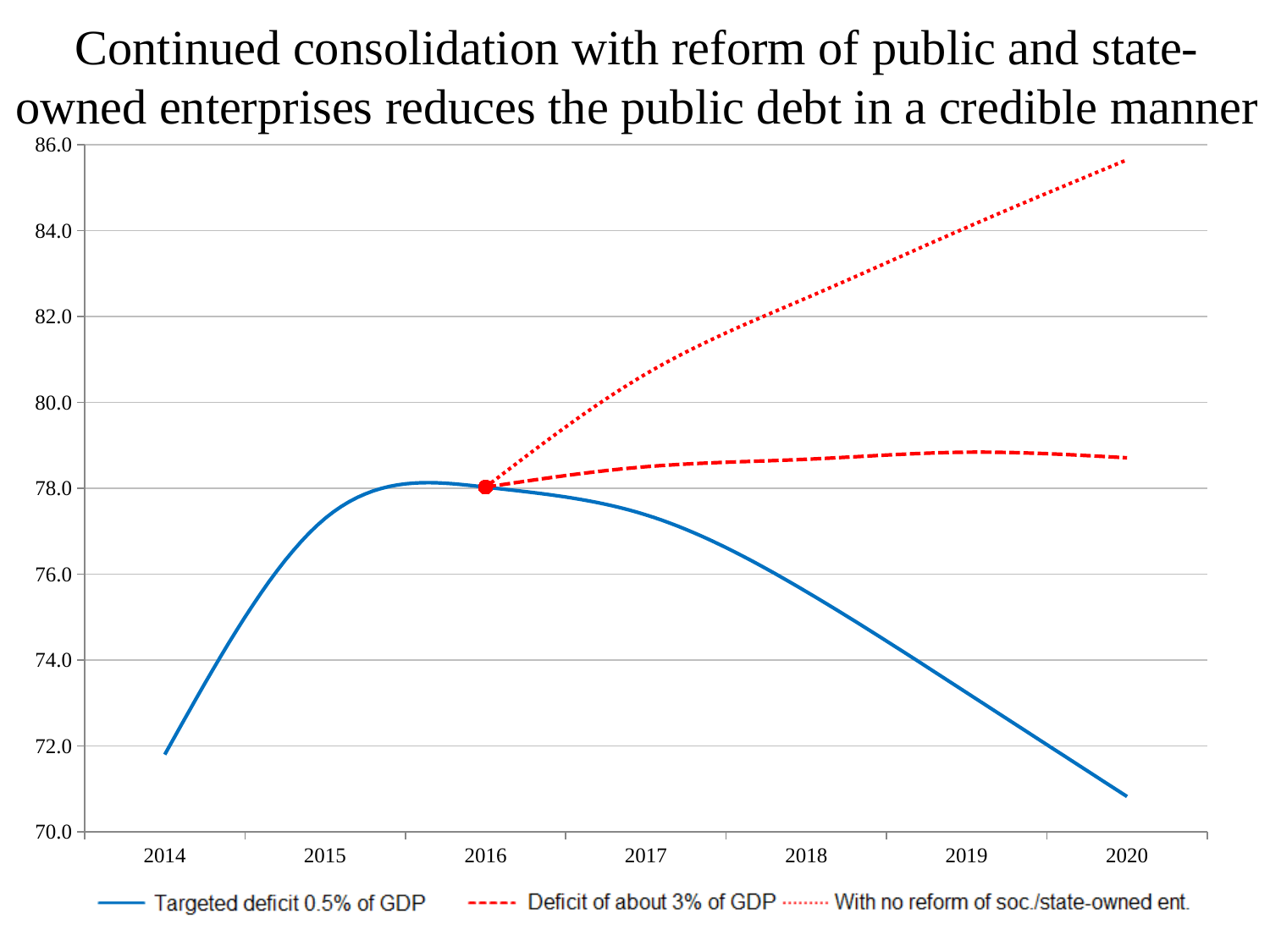
How many years are shown on the x axis? 7 Is the value for 'With no reform of soc./state-owned ent.' in 2020 greater or less than 84.0? greater Which legend entry corresponds to the solid blue line? Targeted deficit 0.5% of GDP Is the value for 'Targeted deficit 0.5% of GDP' in 2014 greater or less than 74.0? less Is the value for 'Targeted deficit 0.5% of GDP' in 2020 greater or less than 72.0? less Does the 'Targeted deficit 0.5% of GDP' series rise or fall from 2016 to 2020? fall How many series does the legend list? 3 In 2020, which series has the higher value: 'Deficit of about 3% of GDP' or 'Targeted deficit 0.5% of GDP'? Deficit of about 3% of GDP Which series has the highest value in 2020? With no reform of soc./state-owned ent. Does the 'With no reform of soc./state-owned ent.' series rise or fall from 2016 to 2020? rise What kind of chart is shown on the slide? line chart